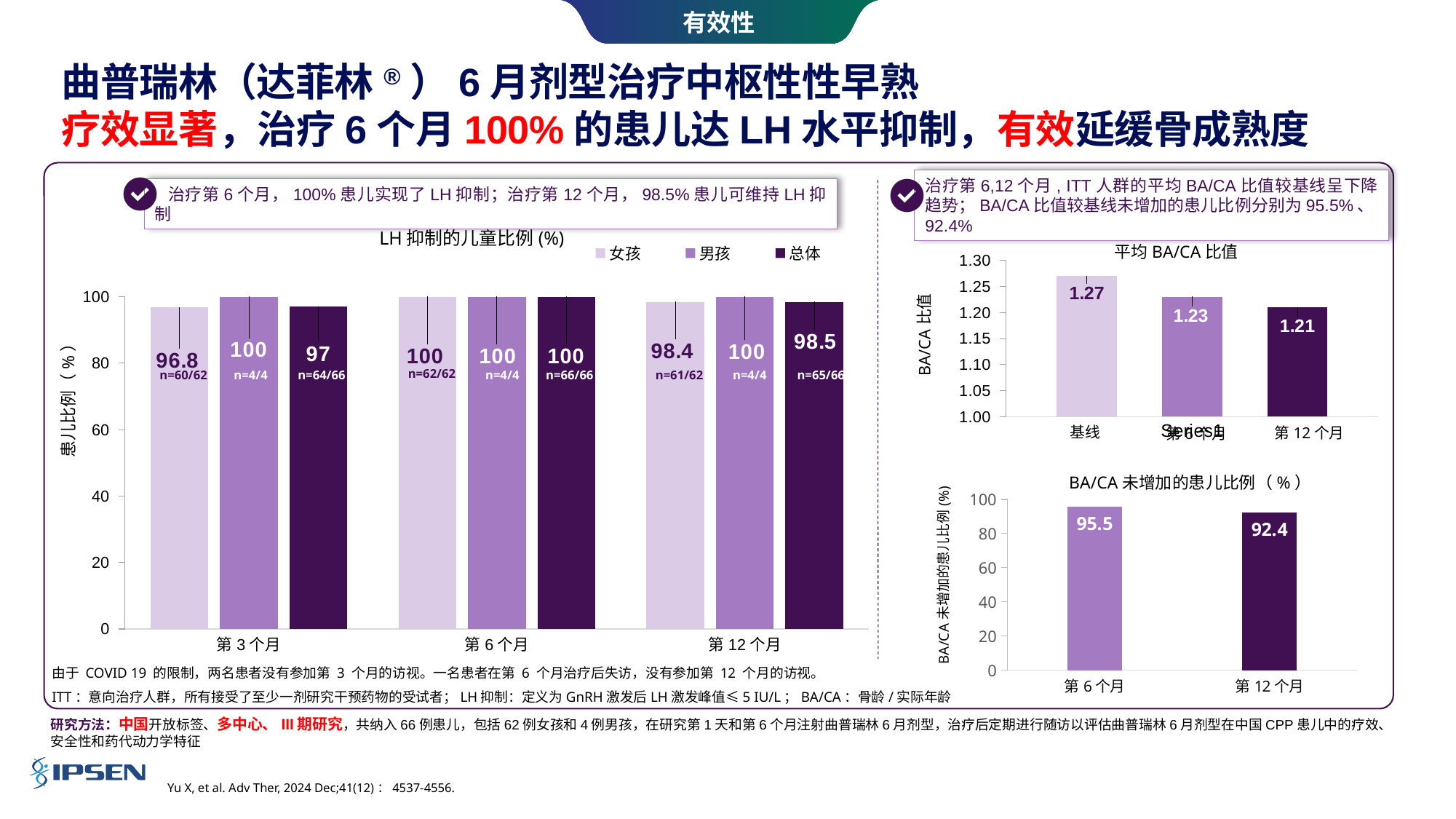
In the chart titled 'BA/CA 未增加的患儿比例（%）', how many categories are shown on the x axis? 2 In the chart titled 'LH抑制的儿童比例 (%)', which is larger at 第 12 个月: the value for 女孩 or the value for 男孩? 男孩 In the chart titled '平均 BA/CA 比值', what is the value for 基线? 1.27 What kind of chart is the chart titled 'BA/CA 未增加的患儿比例（%）'? bar chart In the chart titled 'LH抑制的儿童比例 (%)', how many series does the legend list? 3 In the chart titled '平均 BA/CA 比值', what is the difference between the 基线 value and the 第 12 个月 value? 0.06 In the chart titled '平均 BA/CA 比值', which category has the lowest value? 第 12 个月 In the chart titled 'BA/CA 未增加的患儿比例（%）', what is the value for 第 12 个月? 92.4 In the chart titled '平均 BA/CA 比值', do the values rise or fall from 基线 to 第 12 个月? fall In the chart titled 'LH抑制的儿童比例 (%)', what is the value for 总体 at 第 12 个月? 98.5 In the chart titled 'LH抑制的儿童比例 (%)', what is the difference between the 总体 value at 第 6 个月 and the 总体 value at 第 3 个月? 3 In the chart titled 'LH抑制的儿童比例 (%)', what is the value for 女孩 at 第 3 个月? 96.8